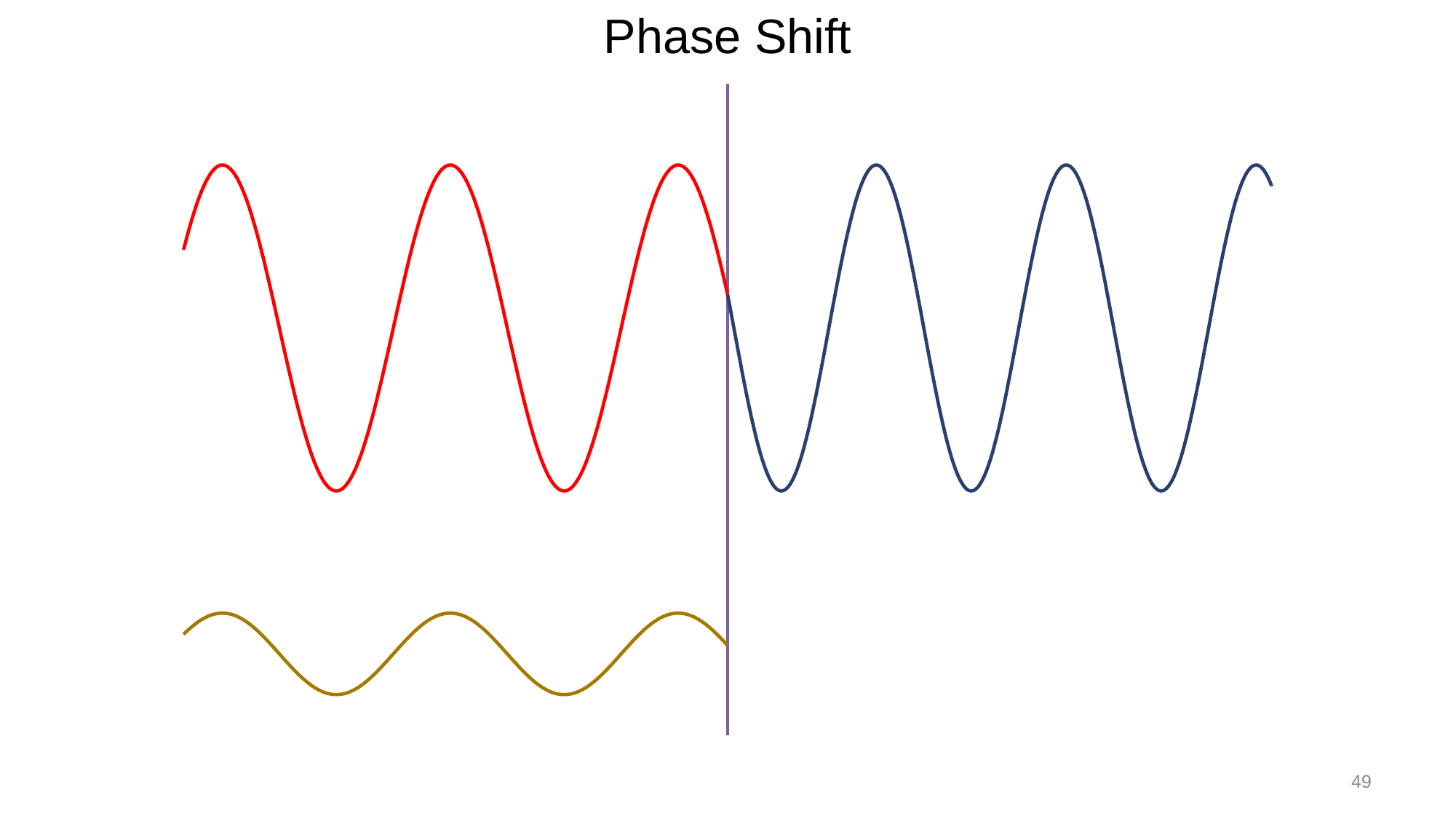
How many peaks does the blue wave have? 3 Which wave is plotted to the right of the purple vertical line? the blue wave What kind of chart is shown on the slide? line chart How many wave curves are plotted on the slide? 3 Which wave has the larger amplitude, the red wave or the gold wave? red wave How many peaks does the gold wave at the bottom have? 3 What is the title of the chart on the slide? Phase Shift